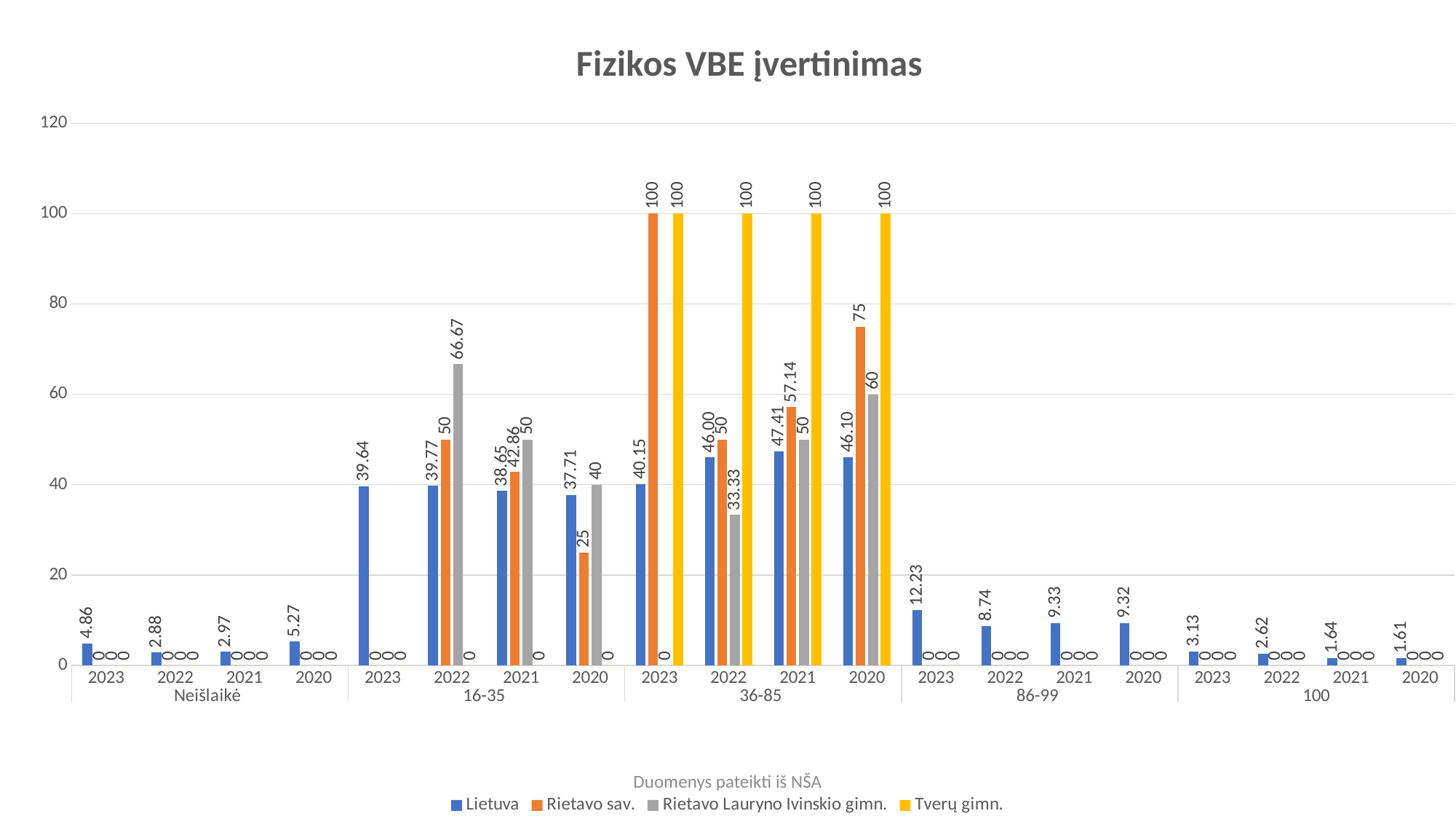
Which year has the lowest Lietuva value in the 100 group? 2020 In the 16-35 group for 2021, which is larger: the Rietavo sav. value or the Rietavo Lauryno Ivinskio gimn. value? Rietavo Lauryno Ivinskio gimn. What kind of chart is shown on the slide? bar chart What is the value for Rietavo Lauryno Ivinskio gimn. in the 16-35 group for 2022? 66.67 What is the value for Tverų gimn. in the 36-85 group for 2020? 100 What is the value for Lietuva in the 86-99 group for 2023? 12.23 What is the value for Lietuva in the Neišlaikė group for 2023? 4.86 How many series does the legend list? 4 What is the difference between the Rietavo sav. value and the Lietuva value in the 36-85 group for 2020? 28.90 What is the value for Rietavo sav. in the 36-85 group for 2021? 57.14 What is the title of the chart? Fizikos VBE įvertinimas Which year has the highest Lietuva value in the 36-85 group? 2021